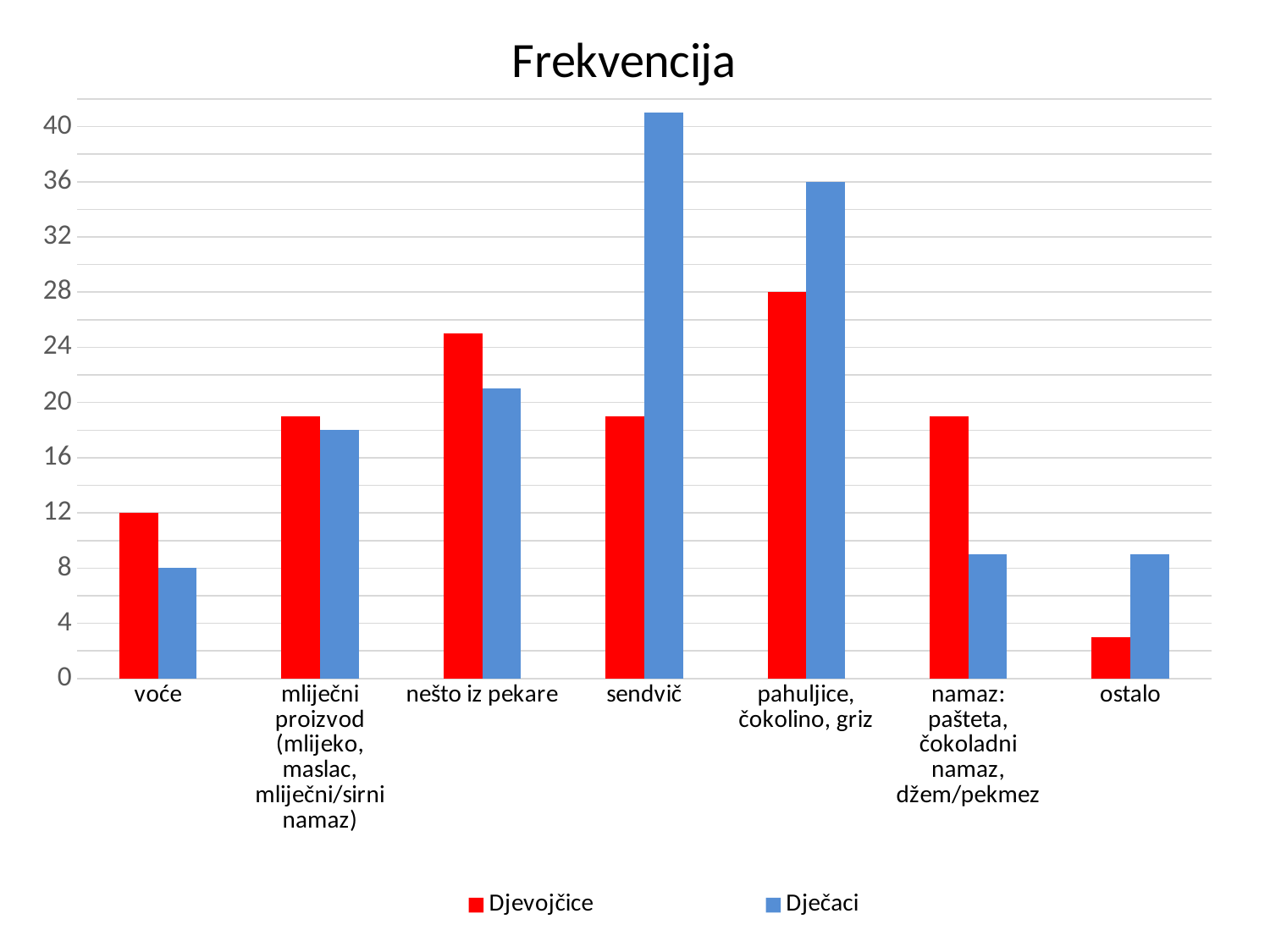
How many categories are shown on the x axis? 7 What is the difference between the Dječaci and Djevojčice values in the pahuljice, čokolino, griz category? 8 What is the value for Dječaci in the voće category? 8 What is the title of the chart? Frekvencija What is the value for Djevojčice in the voće category? 12 How many series does the legend list? 2 What type of chart is shown on the slide? bar chart What is the value for Dječaci in the pahuljice, čokolino, griz category? 36 Which category has the highest value for Dječaci? sendvič What is the value for Djevojčice in the pahuljice, čokolino, griz category? 28 Is the value for Dječaci in the sendvič category greater or less than 40? greater Which category has the lowest value for Djevojčice? ostalo